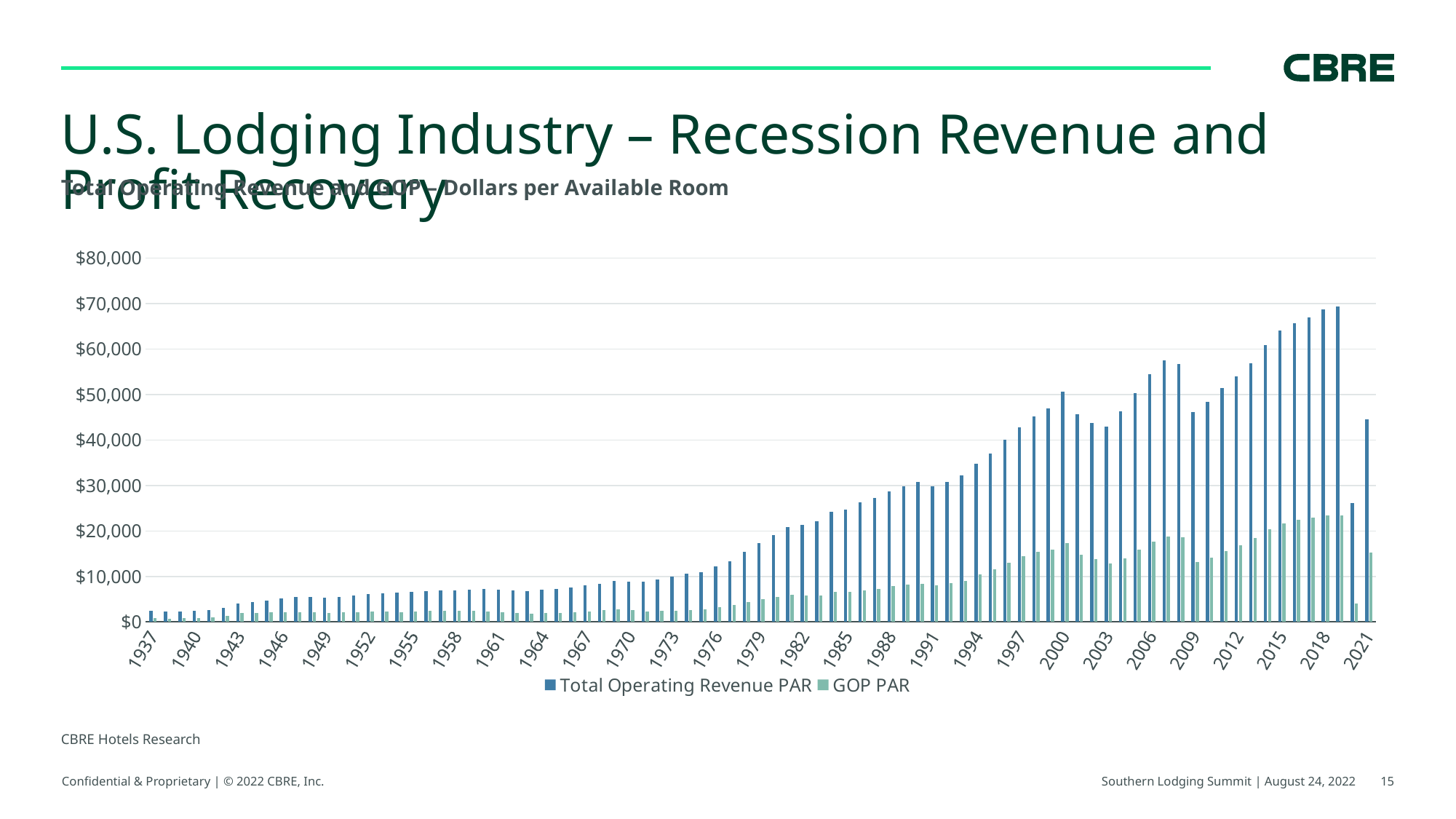
Is the Total Operating Revenue PAR for 2009 greater or less than $50,000? less Does Total Operating Revenue PAR generally rise or fall from 1937 to 2019? rise Is the Total Operating Revenue PAR for 2021 greater or less than $40,000? greater Is the Total Operating Revenue PAR for 2020 greater or less than $30,000? less Which is larger, the Total Operating Revenue PAR for 2020 or for 2021? 2021 What are the two series named in the legend? Total Operating Revenue PAR and GOP PAR What kind of chart is shown on the slide? bar chart How many series does the legend list? 2 Which is larger, the Total Operating Revenue PAR for 2000 or for 2001? 2000